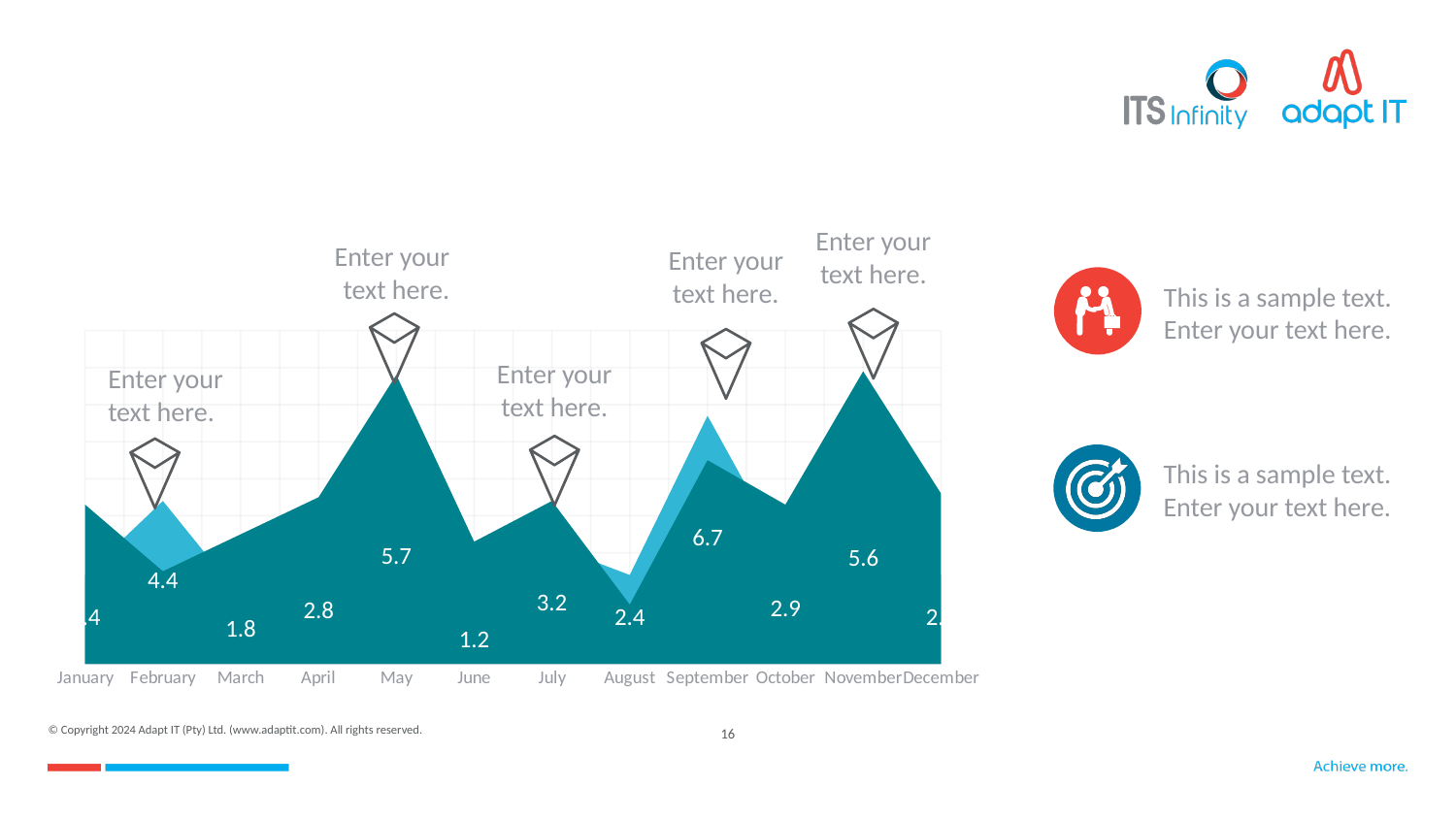
What is the value labelled for May? 5.7 What is the value labelled for February? 4.4 What is the difference between the labelled values for May and March? 3.9 Which has the larger labelled value, May or June? May What is the value labelled for November? 5.6 Do the values rise or fall from March to May? rise How many months are shown along the x axis of the chart? 12 What is the value labelled for September? 6.7 What kind of chart is shown on the slide? area chart What is the value labelled for June? 1.2 Which month has the lowest labelled value? June What is the value labelled for August? 2.4